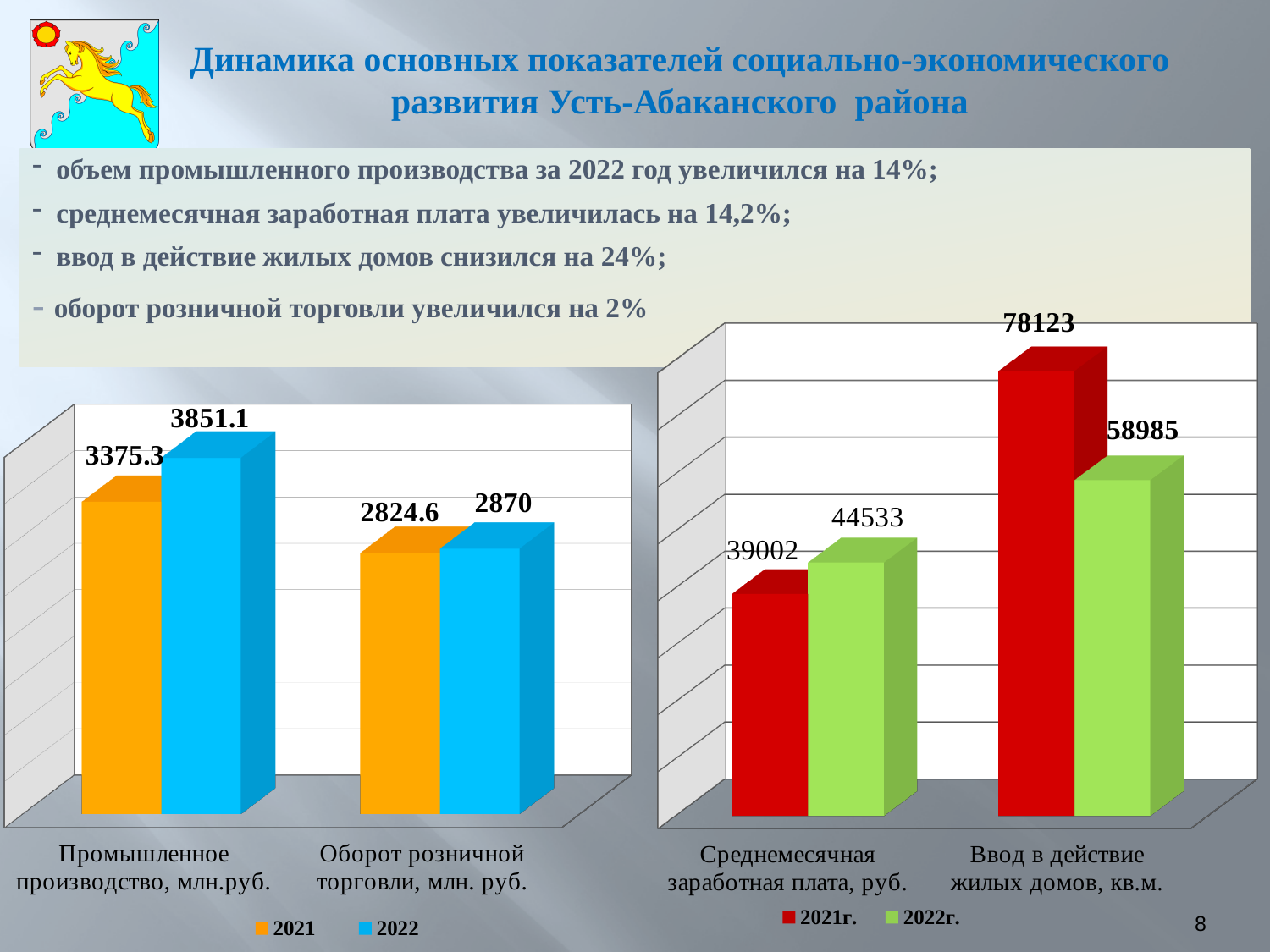
In the left chart, what is the 2022 value for Промышленное производство, млн.руб.? 3851.1 What type of chart is the left chart? Bar chart In the left chart, what is the difference between the 2022 and 2021 values for Промышленное производство, млн.руб.? 475.8 How many series does the legend of the right chart list? 2 In the right chart, which year has the larger value for Ввод в действие жилых домов, кв.м.: 2021г. or 2022г.? 2021г. In the right chart, what is the 2022г. value for Ввод в действие жилых домов, кв.м.? 58985 In the right chart, what is the difference between the 2021г. and 2022г. values for Ввод в действие жилых домов, кв.м.? 19138 In the right chart, which bar has the highest value? Ввод в действие жилых домов, кв.м., 2021г. (78123) In the left chart, which bar has the lowest value? Оборот розничной торговли, млн. руб., 2021 (2824.6) In the left chart, which year has the larger value for Оборот розничной торговли, млн. руб.: 2021 or 2022? 2022 In the right chart, what is the 2021г. value for Среднемесячная заработная плата, руб.? 39002 In the left chart, what is the 2021 value for Оборот розничной торговли, млн. руб.? 2824.6